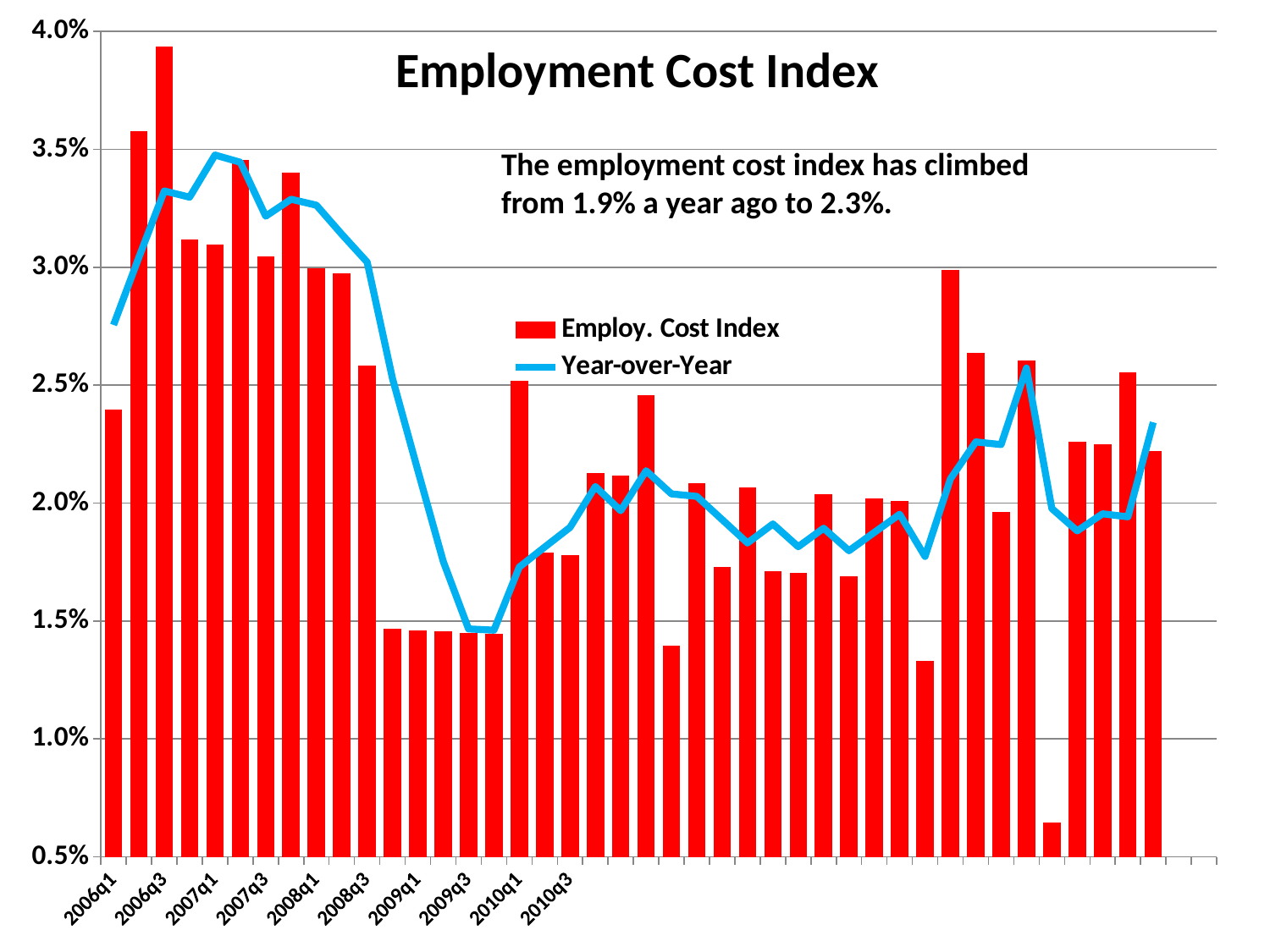
Which labeled quarter has the tallest Employ. Cost Index bar? 2006q3 How many series does the legend list? 2 Is the Employ. Cost Index value for 2009q3 greater or less than 2.0%? less Is the Employ. Cost Index value for 2010q3 greater or less than 2.0%? less Does the Year-over-Year line rise or fall between 2007q1 and 2009q3? fall What kind of chart is this? Bar chart with a line series What is the title of the chart? Employment Cost Index Which is larger, the Employ. Cost Index bar for 2006q3 or for 2007q1? 2006q3 Is the Employ. Cost Index value for 2006q1 greater or less than 2.5%? less Which is larger, the Employ. Cost Index bar for 2009q1 or for 2010q1? 2010q1